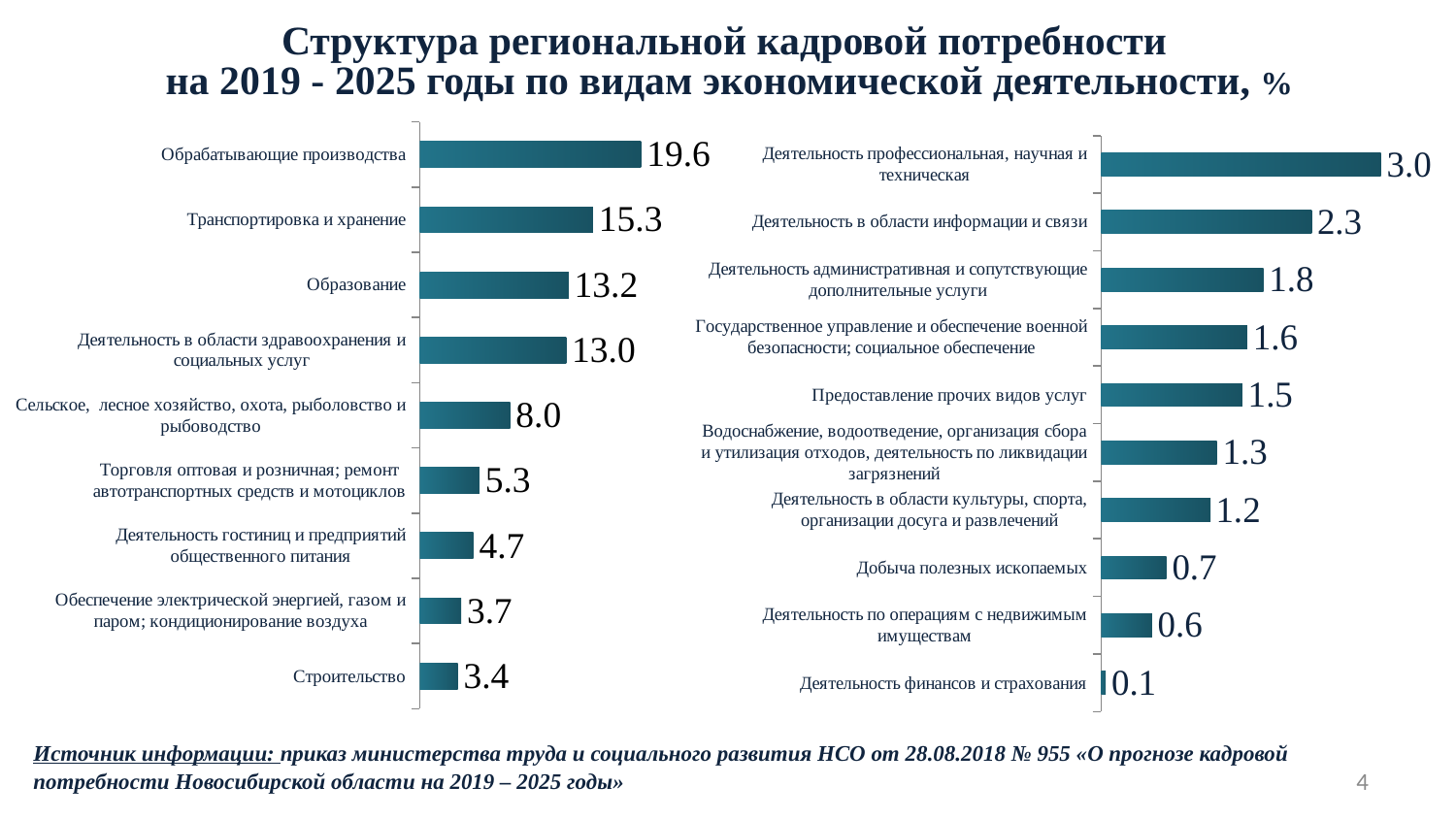
On the right chart, which category has the lowest value? Деятельность финансов и страхования On the right chart, what is the difference between Деятельность профессиональная, научная и техническая and Предоставление прочих видов услуг? 1.5 On the right chart, what is the value for Деятельность в области информации и связи? 2.3 On the left chart, what is the value for Обрабатывающие производства? 19.6 How many categories are shown on the right chart? 10 On the left chart, what is the difference between Транспортировка и хранение and Образование? 2.1 On the left chart, which is larger: Сельское, лесное хозяйство, охота, рыболовство и рыбоводство or Торговля оптовая и розничная; ремонт автотранспортных средств и мотоциклов? Сельское, лесное хозяйство, охота, рыболовство и рыбоводство On the left chart, what is the value for Строительство? 3.4 On the left chart, which category has the highest value? Обрабатывающие производства How many categories are shown on the left chart? 9 On the right chart, what is the value for Добыча полезных ископаемых? 0.7 What type of chart is the left chart? Bar chart